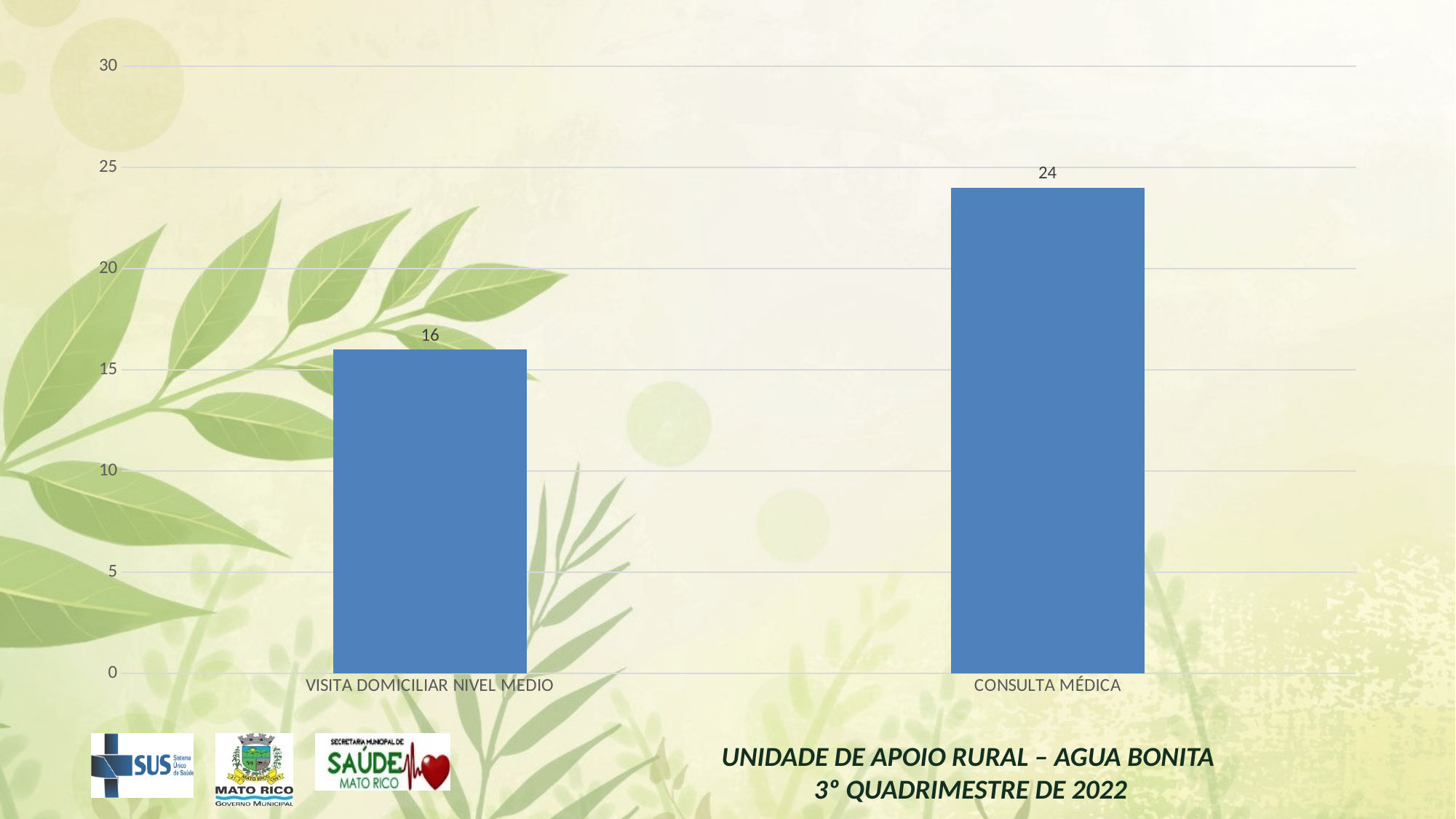
Which is larger, the value for VISITA DOMICILIAR NIVEL MEDIO or the value for CONSULTA MÉDICA? CONSULTA MÉDICA What is the difference between the values for CONSULTA MÉDICA and VISITA DOMICILIAR NIVEL MEDIO? 8 What is the highest value shown on the vertical axis? 30 Which category has the lowest value? VISITA DOMICILIAR NIVEL MEDIO Is the value for VISITA DOMICILIAR NIVEL MEDIO greater or less than 20? less How many categories are shown in the chart? 2 What kind of chart is shown on the slide? bar chart What is the value for VISITA DOMICILIAR NIVEL MEDIO? 16 What colour are the bars in the chart? blue Which category has the highest value? CONSULTA MÉDICA What is the value for CONSULTA MÉDICA? 24 Is the value for CONSULTA MÉDICA greater or less than 20? greater